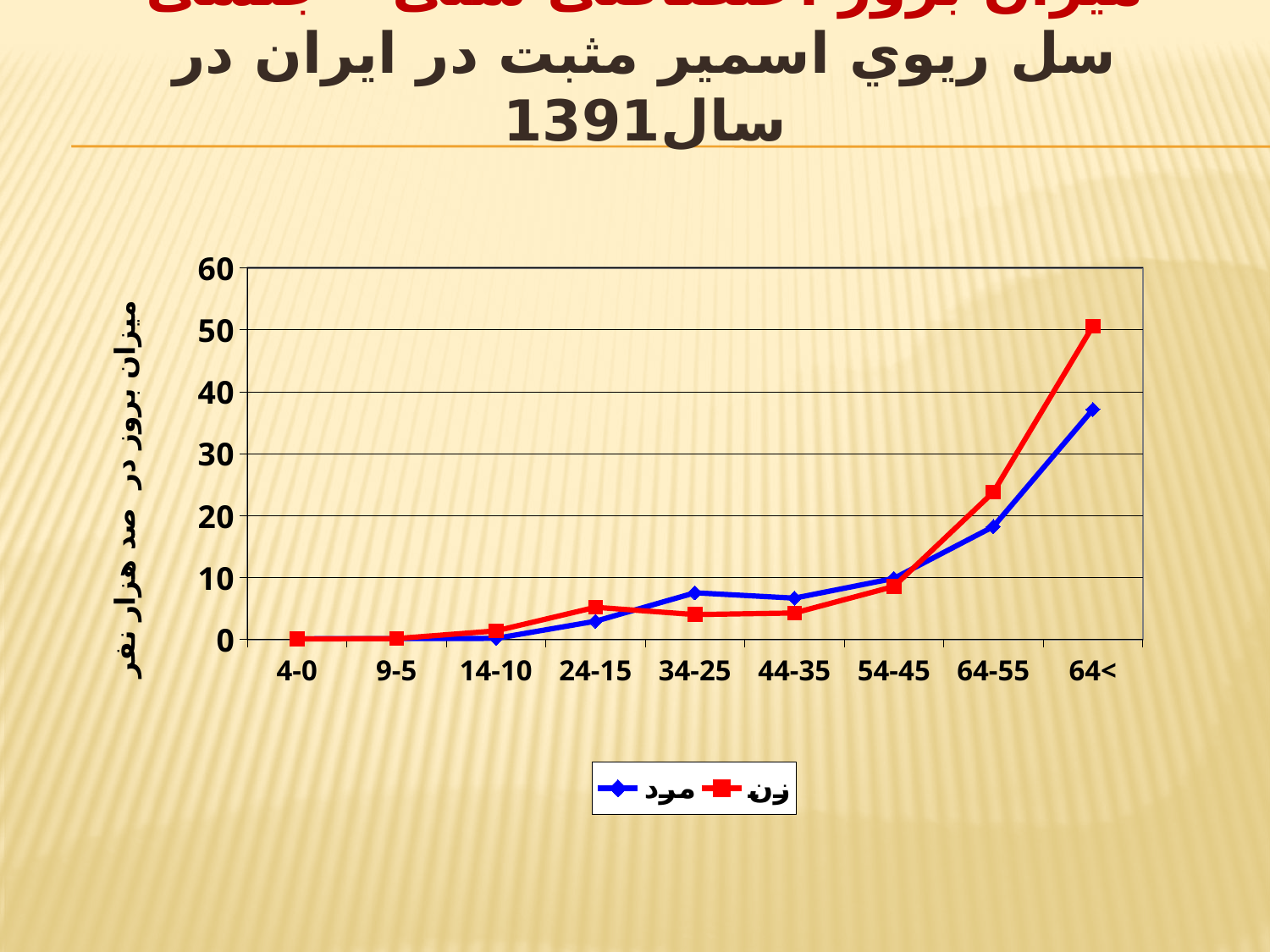
Is the value for زن in the 64< age group greater or less than 40? greater How many age-group categories are shown on the x axis? 9 Is the value for مرد in the 64-55 age group greater or less than 20? less Is the value for مرد in the 64< age group greater or less than 40? less In the 34-25 age group, which series has the larger value, مرد or زن? مرد How many series does the legend list? 2 Which age group has the highest value for the زن (red) series? 64< What kind of chart is shown on the slide? line chart In the 64< age group, which series has the larger value, مرد or زن? زن Which age group has the highest value for the مرد (blue) series? 64< Do the values generally rise or fall as age increases along the x axis? rise